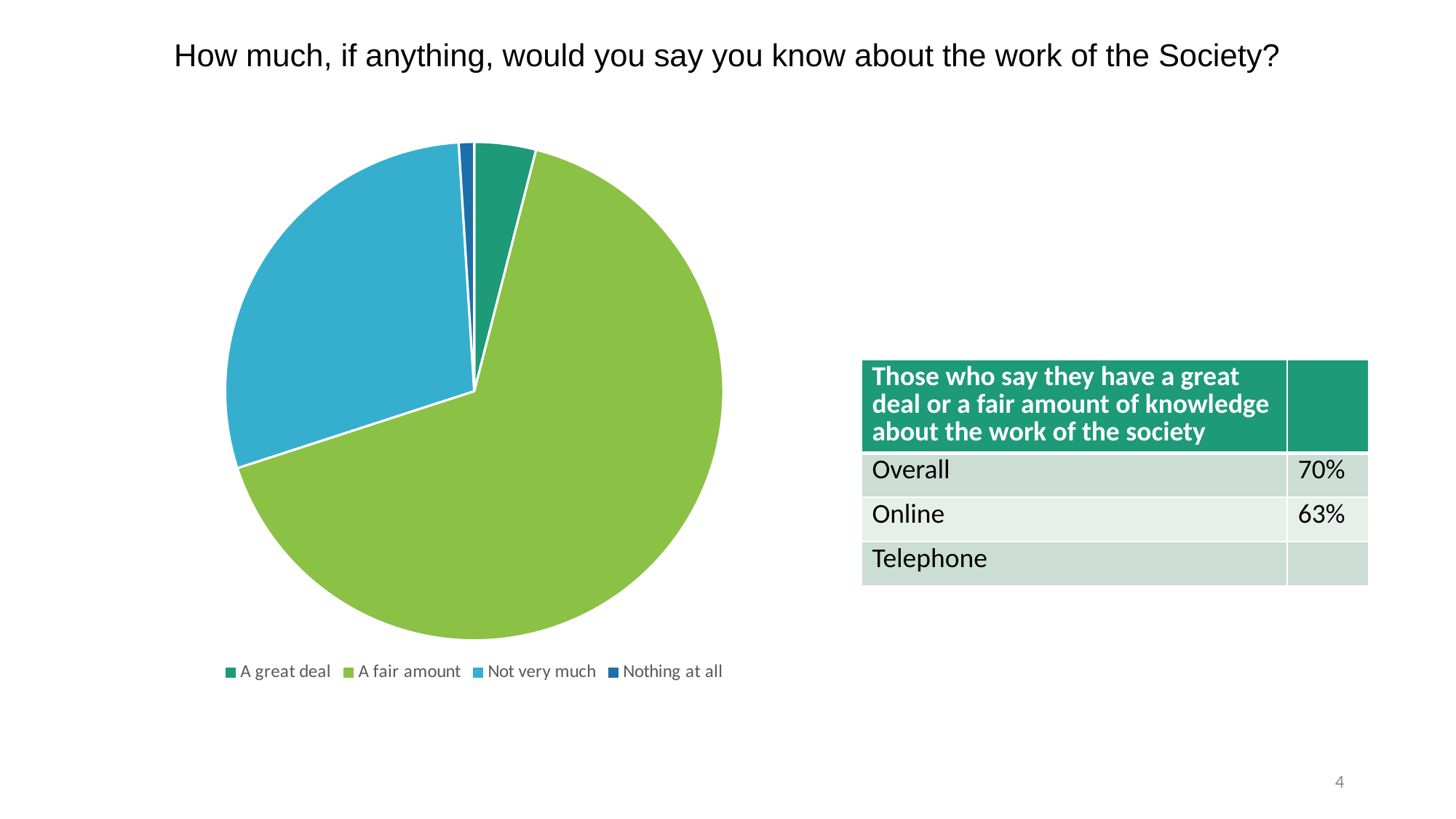
How many entries does the legend of the pie chart list? 4 Which category has the largest slice of the pie chart? A fair amount Which is the second-largest slice in the pie chart? Not very much What colour is the 'A fair amount' slice in the pie chart? Green How many slices does the pie chart have? 4 Which slice is larger in the pie chart, 'A fair amount' or 'Not very much'? A fair amount Which category has the smallest slice of the pie chart? Nothing at all Which slice is larger in the pie chart, 'Not very much' or 'A great deal'? Not very much What question does the title above the pie chart ask? How much, if anything, would you say you know about the work of the Society? What kind of chart is shown on the slide? Pie chart